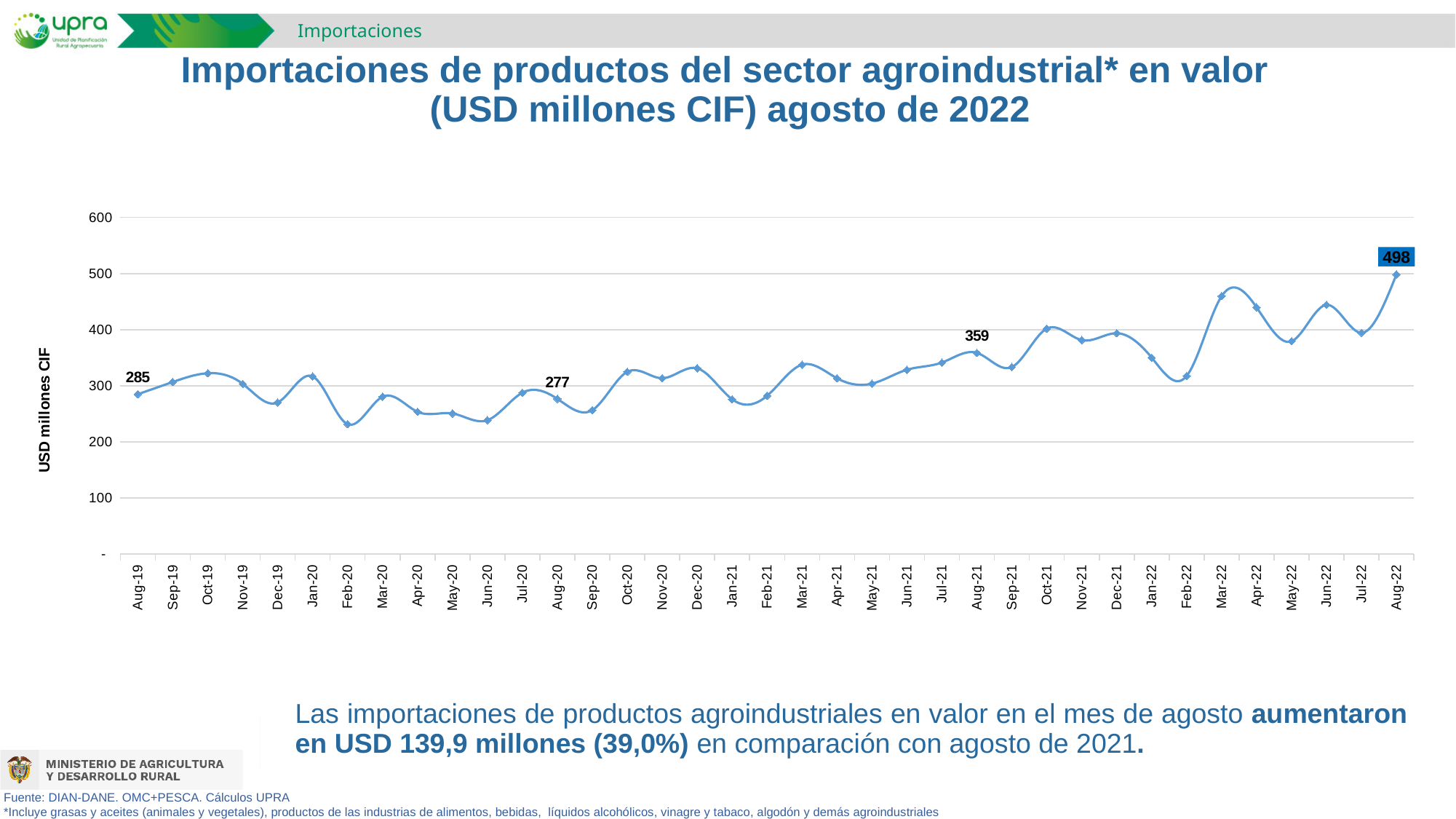
Which month has the highest value? Aug-22 What kind of chart is shown? line chart What is the value for Aug-19? 285 What is the difference between the values for Aug-22 and Aug-21? 139 What is the difference between the values for Aug-21 and Aug-20? 82 What is the value for Aug-22? 498 Is the value for Feb-20 greater or less than 300? less Which is larger, the value for Aug-19 or the value for Aug-20? Aug-19 What is the value for Aug-21? 359 What is the value for Aug-20? 277 How many monthly data points are plotted? 37